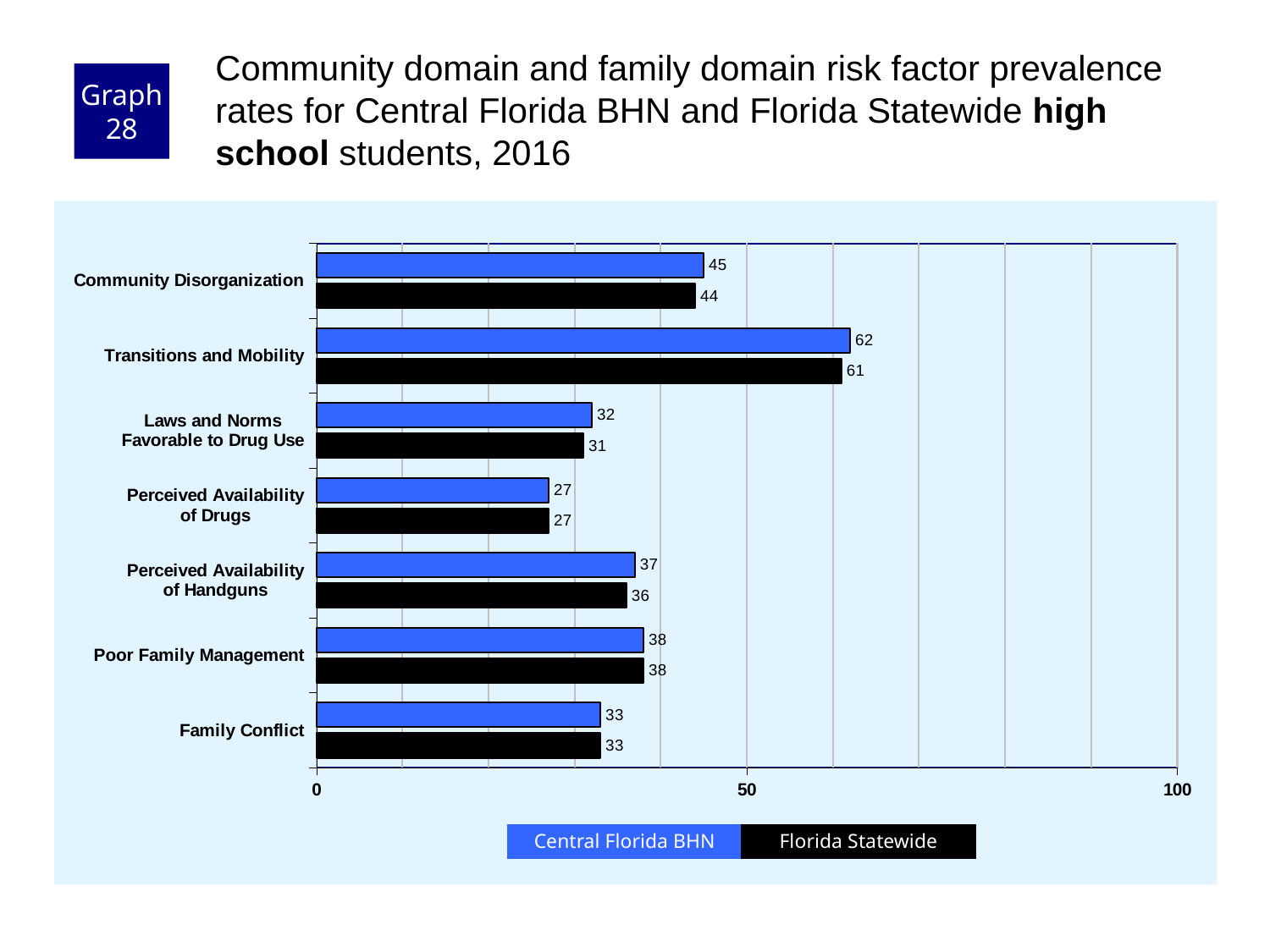
What is the Florida Statewide value for Community Disorganization? 44 What is the Central Florida BHN value for Transitions and Mobility? 62 What is the difference between the Central Florida BHN values for Transitions and Mobility and Community Disorganization? 17 How many risk factor categories are shown on the chart? 7 How many series does the legend list? 2 Which risk factor has the highest Central Florida BHN value? Transitions and Mobility Which colour represents Florida Statewide in the chart? black Is the Central Florida BHN value for Transitions and Mobility greater or less than 50? greater What is the difference between the Central Florida BHN and Florida Statewide values for Transitions and Mobility? 1 What kind of chart is shown on the slide? bar chart What is the Florida Statewide value for Laws and Norms Favorable to Drug Use? 31 Which risk factor has the lowest Florida Statewide value? Perceived Availability of Drugs